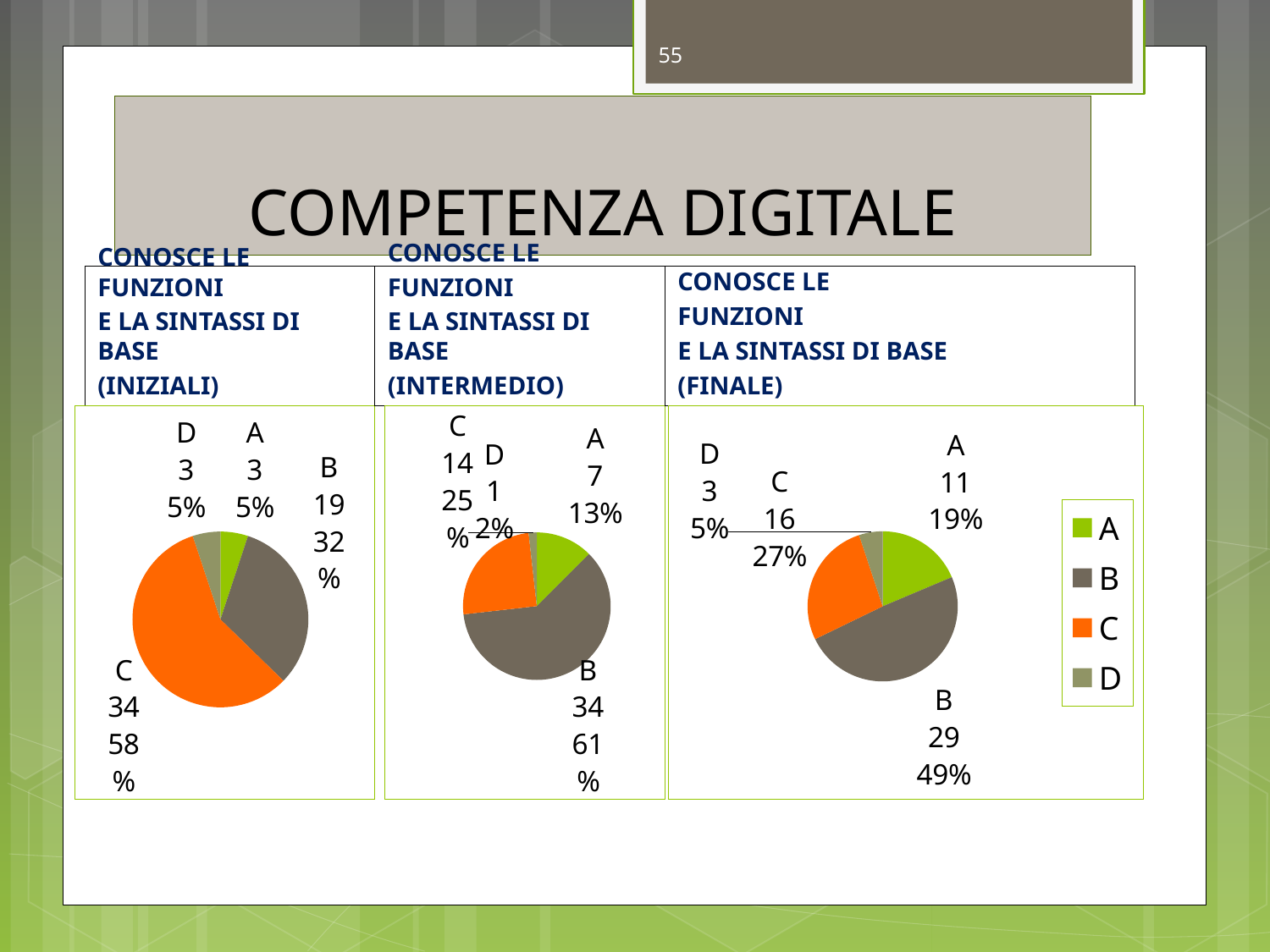
In the INTERMEDIO pie chart, which category has the smallest slice? D In the INIZIALI pie chart, which category has the largest slice? C In the FINALE pie chart, what is the difference in count between category B and category C? 13 In the INTERMEDIO pie chart, what count is shown for category C? 14 What type of chart is used on this slide? Pie chart In the FINALE pie chart, what percentage is shown for category A? 19% In the INTERMEDIO pie chart, what percentage is shown for category B? 61% In the FINALE pie chart, which is larger, the slice for C or the slice for A? C How many categories does the legend list? 4 In the FINALE pie chart, which category has the largest slice? B In the INIZIALI pie chart, what percentage is shown for category C? 58% In the INIZIALI pie chart, what count is shown for category B? 19